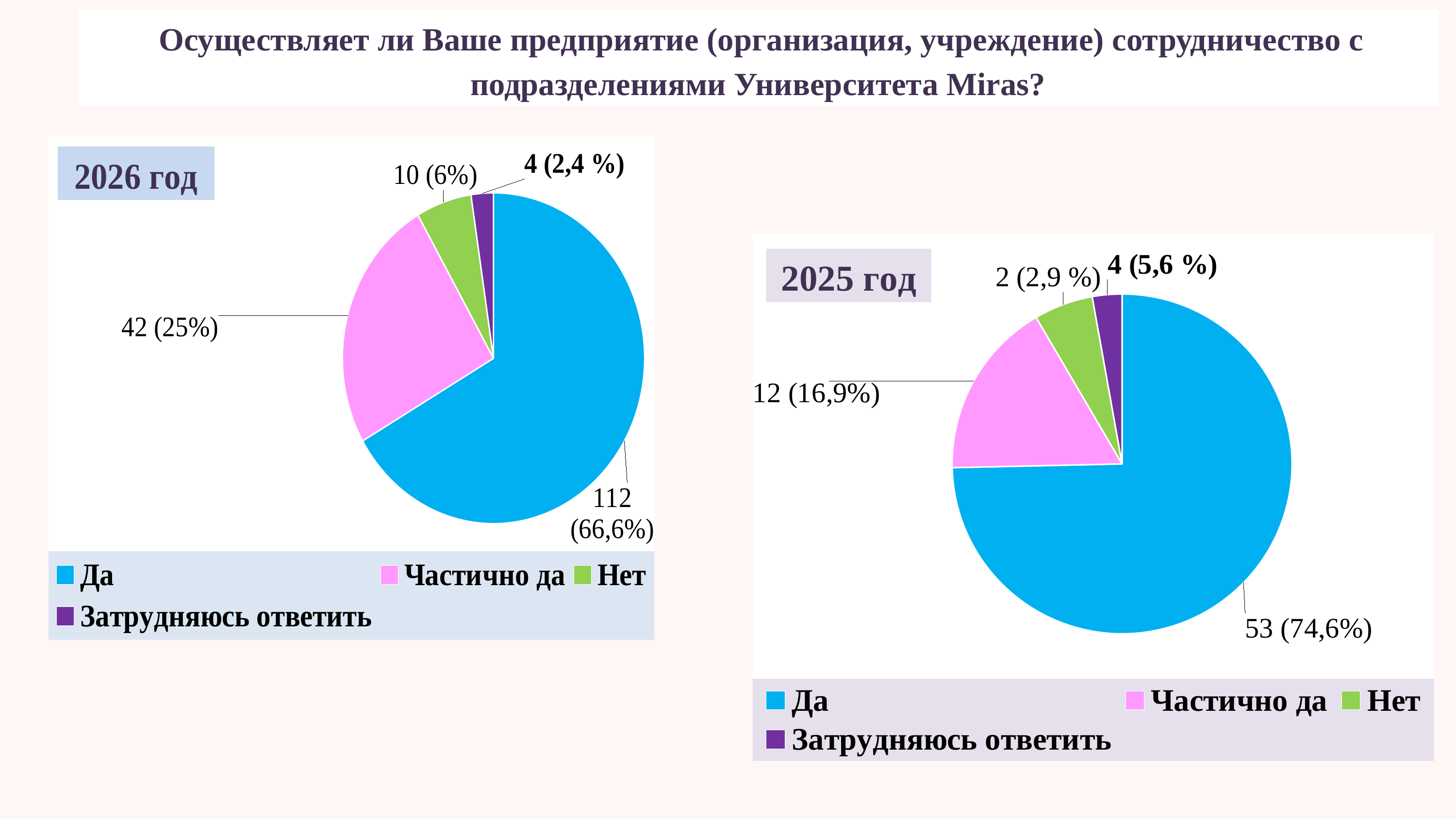
In the "2025 год" pie chart, what percentage share does the "Да" slice have? 74,6% In the "2026 год" pie chart, how many respondents answered "Нет"? 10 In the "2026 год" pie chart, what is the data label for the "Да" slice? 112 (66,6%) How many categories does the legend of the "2025 год" pie chart list? 4 What type of chart is used for "2026 год"? Pie chart In the "2025 год" pie chart, what is the data label for the "Частично да" slice? 12 (16,9%) In the "2026 год" pie chart, what is the difference in count between "Да" and "Частично да"? 70 In the "2026 год" pie chart, which colour represents "Затрудняюсь ответить"? Purple Which is larger in the "2025 год" pie chart: the count for "Затрудняюсь ответить" or the count for "Нет"? Нет In the "2025 год" pie chart, which category has the smallest slice? Затрудняюсь ответить In the "2026 год" pie chart, which category has the largest slice? Да In the "2026 год" pie chart, what percentage share does the "Частично да" slice have? 25%